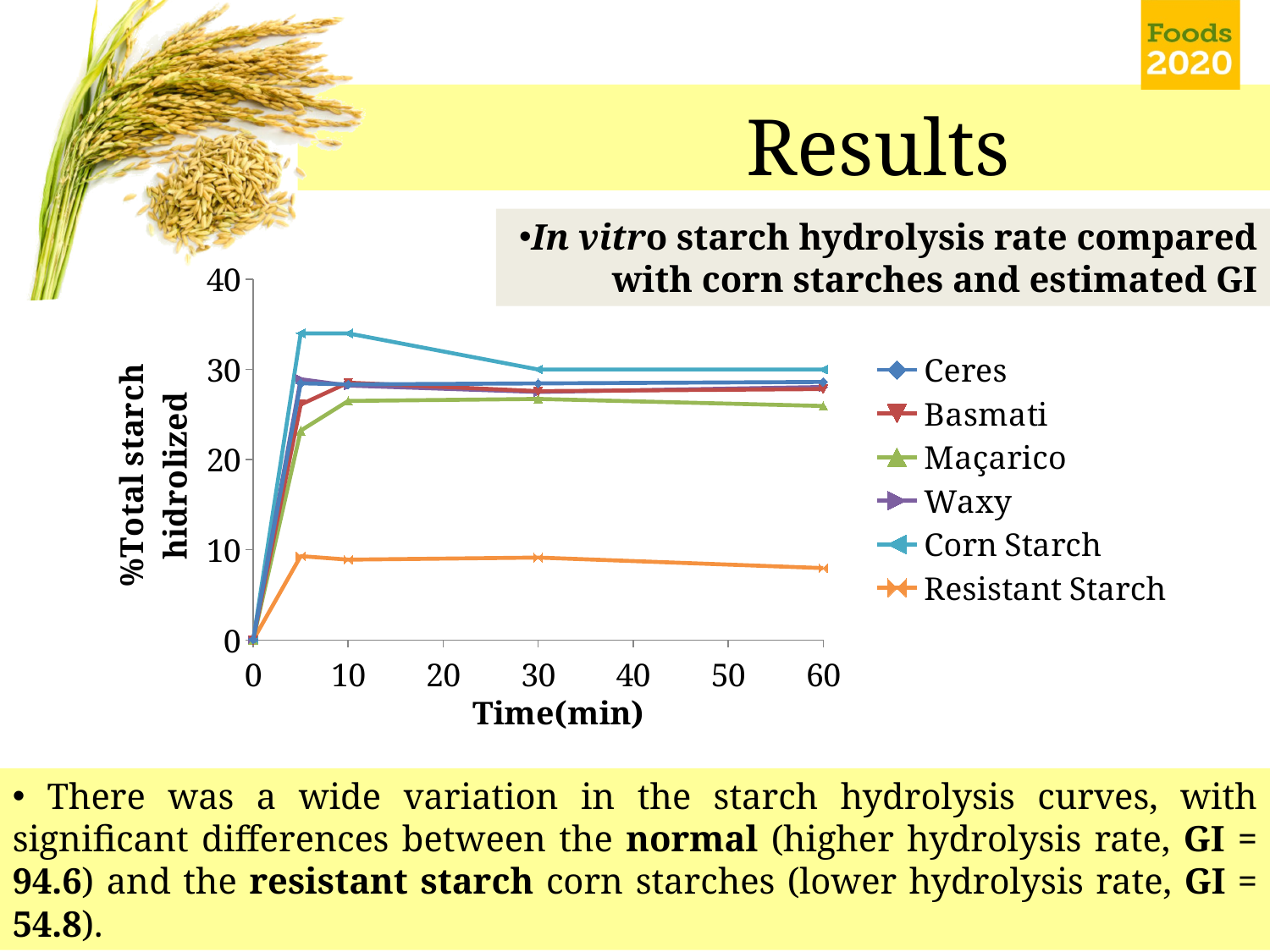
Is the value for Corn Starch at 5 minutes greater or less than 30? greater Which series has the highest value at 5 minutes? Corn Starch What is the label of the y axis? %Total starch hidrolized Does the Corn Starch line rise or fall between 10 and 60 minutes? fall Which is larger at 30 minutes, the value for Corn Starch or the value for Resistant Starch? Corn Starch What is the value for Resistant Starch at time 0? 0 What is the label of the x axis? Time(min) Is the value for Resistant Starch at 60 minutes greater or less than 10? less Which series has the lowest value at 60 minutes? Resistant Starch How many series does the legend list? 6 Is the value for Maçarico at 5 minutes greater or less than 20? greater What kind of chart is shown on the slide? line chart